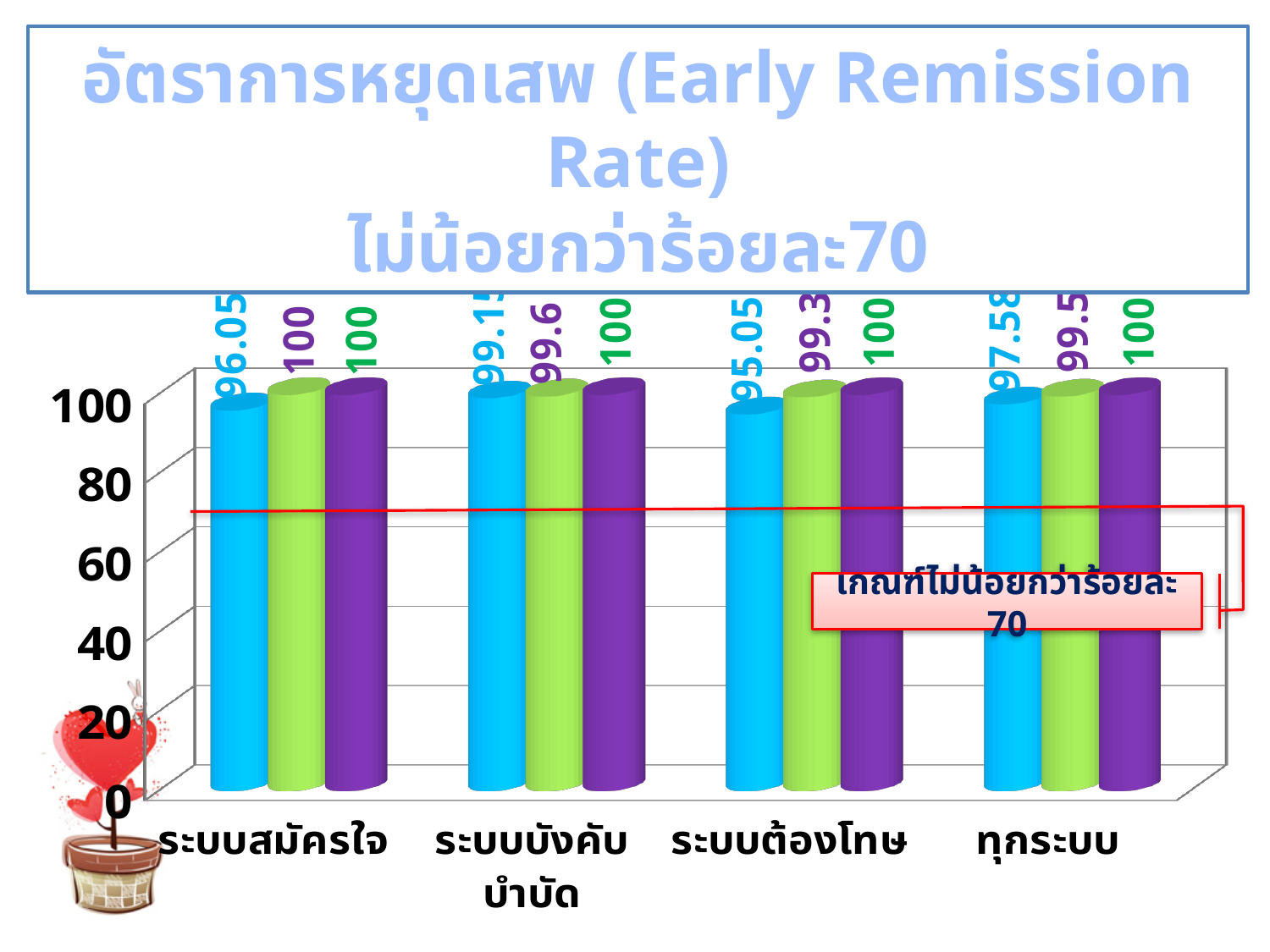
What is the difference between the purple bar and the blue bar for ระบบสมัครใจ? 3.95 What is the value of the blue bar for ระบบสมัครใจ? 96.05 What is the value of the blue bar for ระบบต้องโทษ? 95.05 What type of chart is shown on the slide? bar chart What is the value of the green bar for ระบบบังคับบำบัด? 99.6 How many categories are shown on the x axis of the chart? 4 What is the value of the purple bar for ทุกระบบ? 100 What threshold does the red horizontal line on the chart represent? เกณฑ์ไม่น้อยกว่าร้อยละ 70 Is the value of the blue bar for ระบบต้องโทษ greater or less than 80? greater Which category has the lowest value for the blue bar? ระบบต้องโทษ Which is larger for ระบบต้องโทษ, the blue bar or the green bar? the green bar